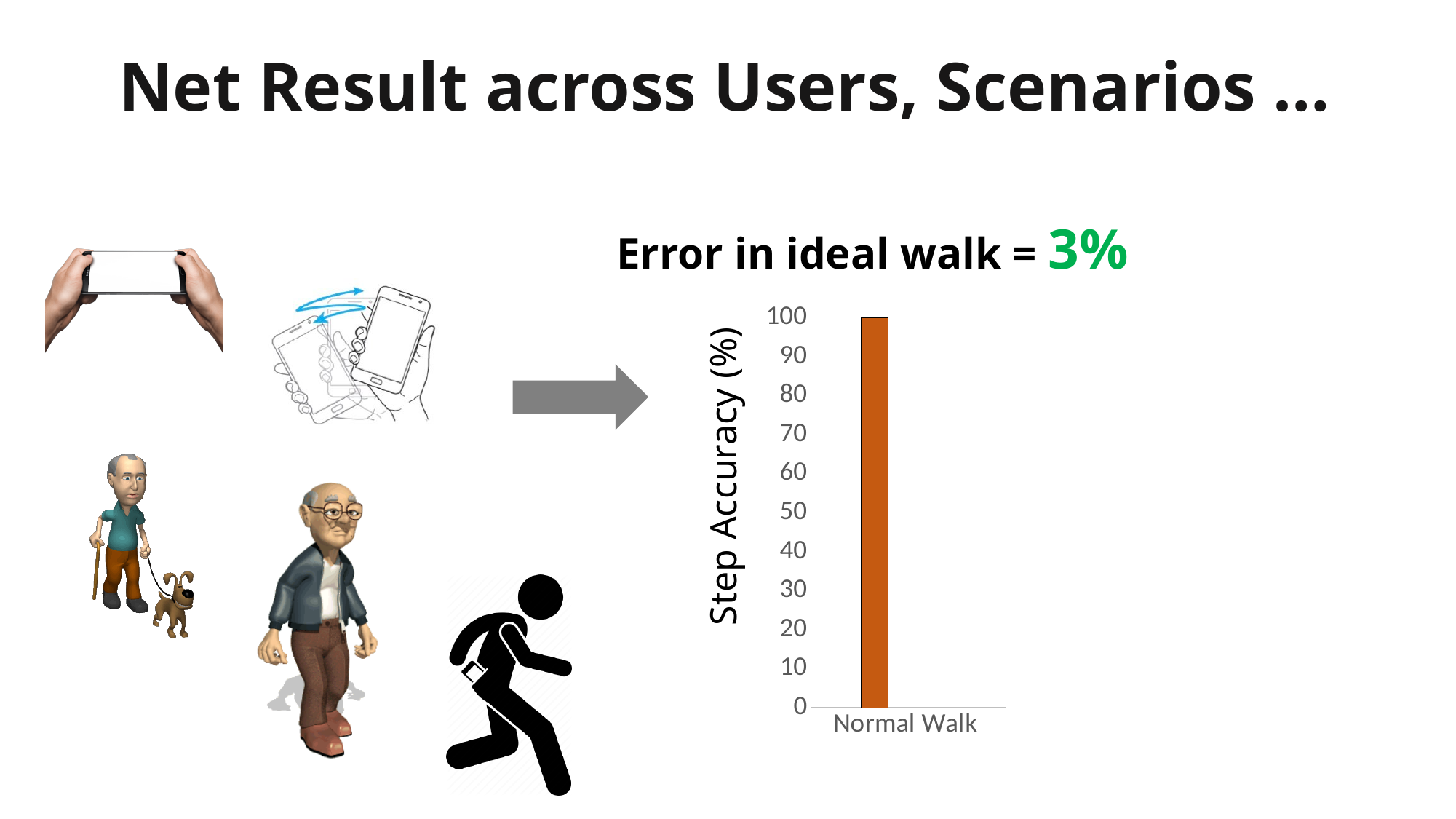
Is the value for Normal Walk greater or less than 90? greater What is the y-axis title of the chart? Step Accuracy (%) How many bars does the chart show? 1 What is the maximum value shown on the y axis of the chart? 100 Is the value for Normal Walk greater or less than 50? greater What is the category label on the x axis of the chart? Normal Walk What kind of chart is shown on the slide? bar chart